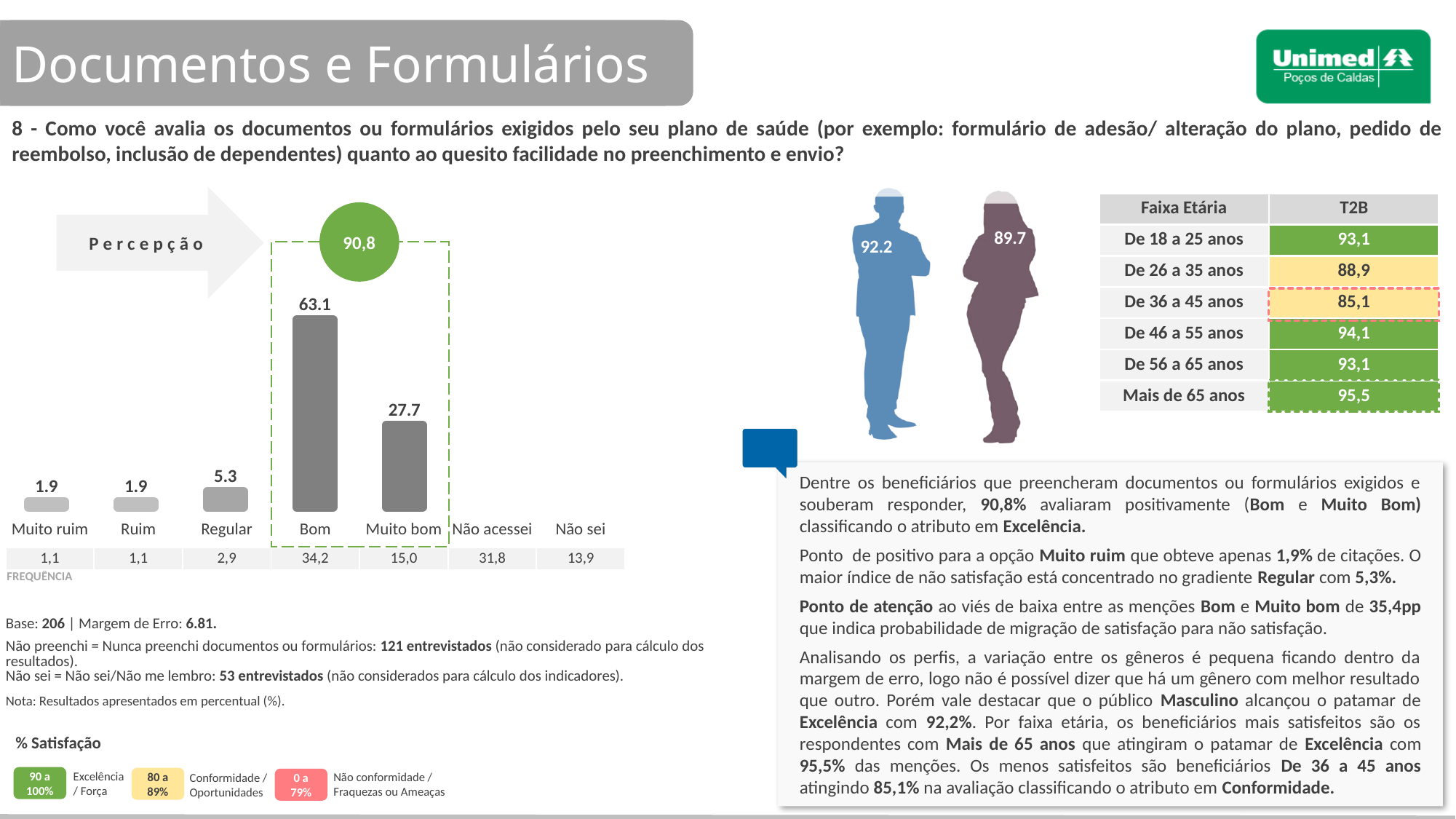
What is the difference between the values for Bom and Muito bom in the bar chart? 35.4 In the Faixa Etária table, which age group has the lowest T2B value? De 36 a 45 anos What is the frequency value shown for Não acessei in the row below the bar chart? 31,8 What is the value shown for the male figure in the gender comparison? 92.2 Which is larger in the bar chart, Regular or Muito bom? Muito bom What value is shown in the green circle above the Bom and Muito bom bars? 90,8 Which category has the highest value in the bar chart? Bom In the Faixa Etária table, what is the T2B value for Mais de 65 anos? 95,5 What is the value for Regular in the bar chart? 5.3 What is the value for Bom in the bar chart? 63.1 What type of chart is used to show the evaluation of documents and forms? bar chart What is the value for Muito bom in the bar chart? 27.7